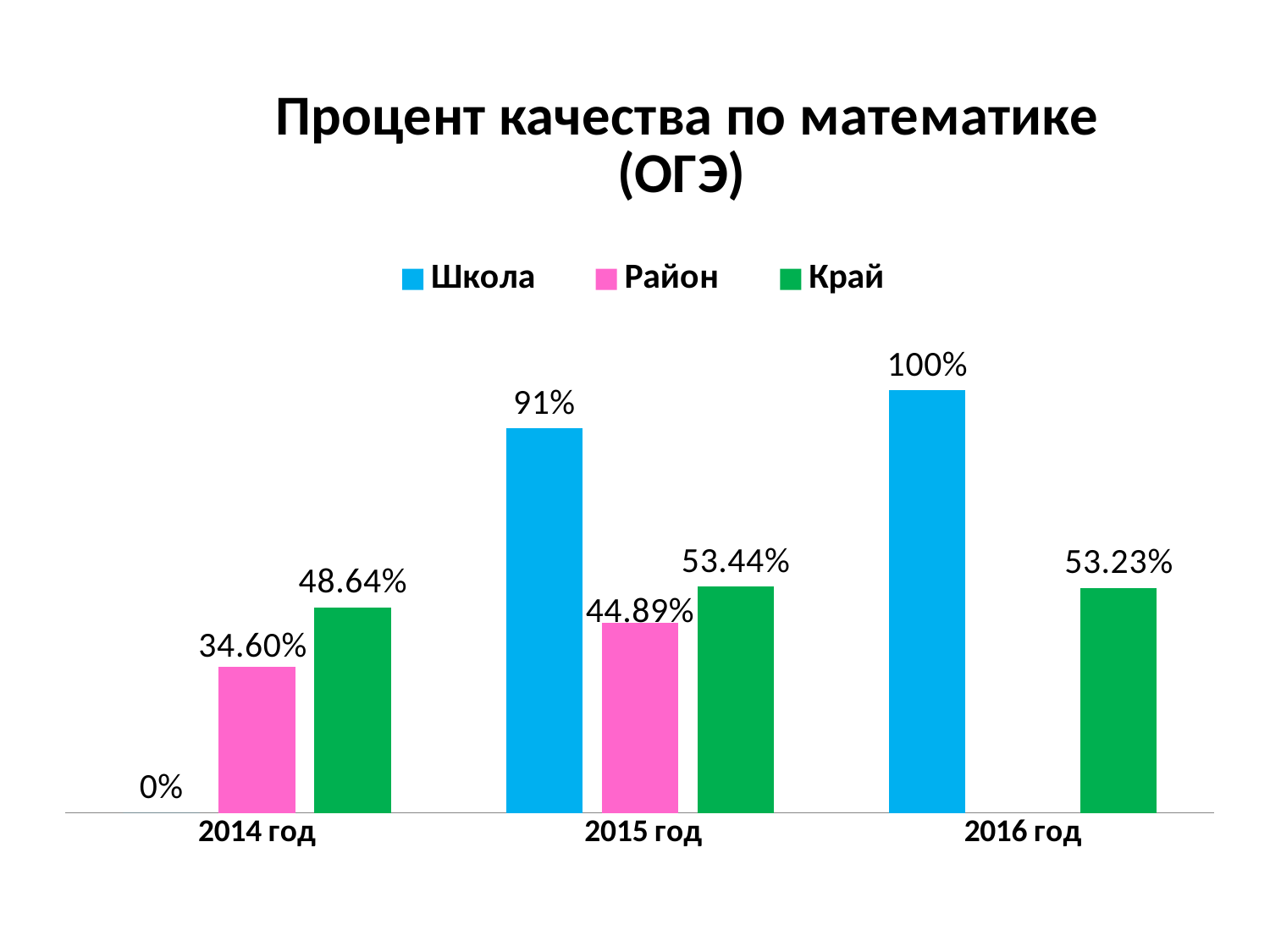
What is the value for Школа in 2014 год? 0% In which year is the value for Край lowest? 2014 год What is the value for Школа in 2015 год? 91% In which year is the value for Школа highest? 2016 год What is the difference between the Школа values for 2016 год and 2015 год? 9% How many year categories are shown on the x axis? 3 Do the values for Школа rise or fall from 2014 год to 2016 год? Rise How many series does the legend list? 3 What is the value for Край in 2016 год? 53.23% Which is larger in 2015 год: Район or Край? Край What is the value for Район in 2014 год? 34.60% What kind of chart is shown on the slide? Bar chart